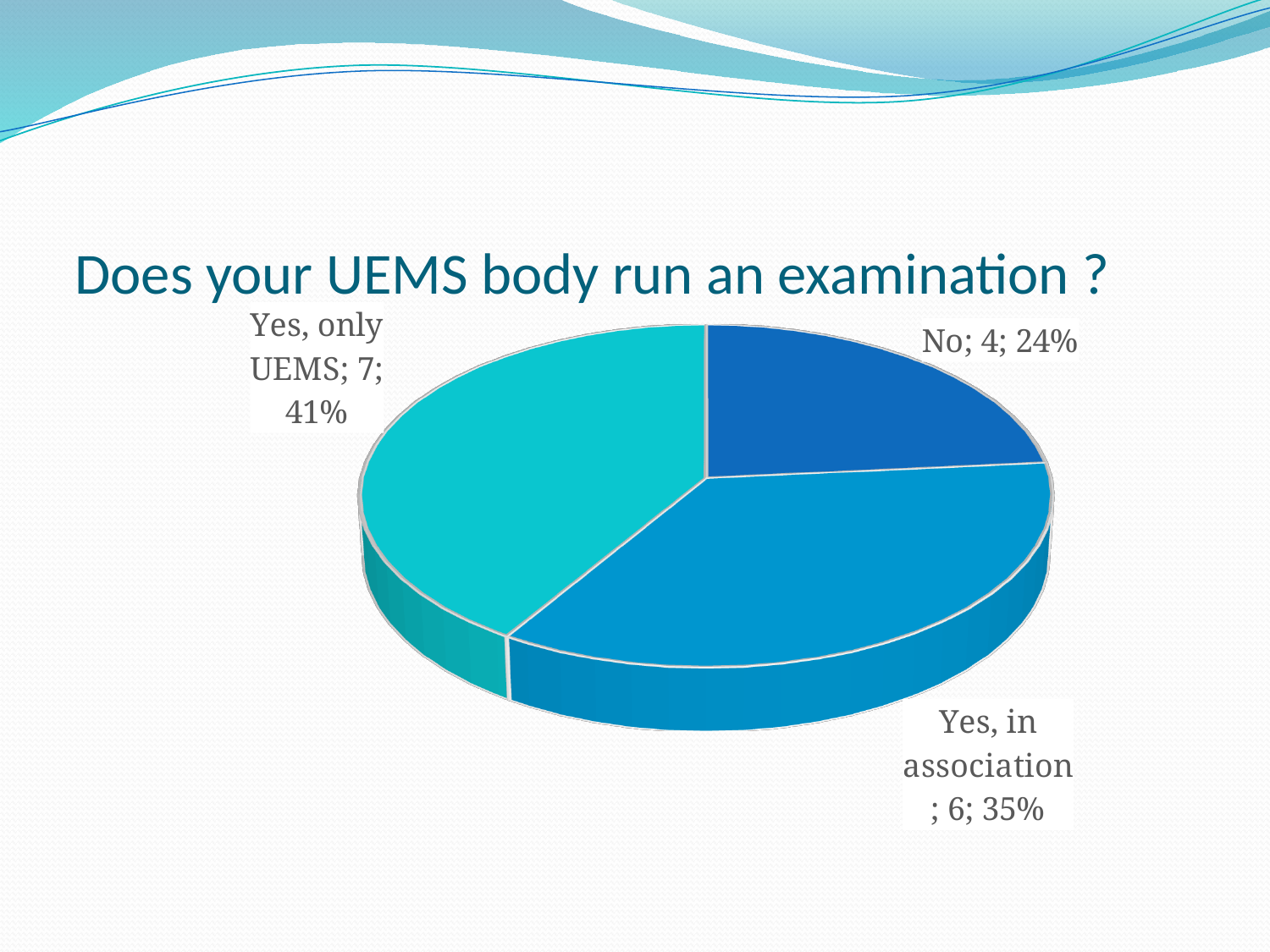
Which slice is the smallest? No What is the title of the chart? Does your UEMS body run an examination ? What percentage share does the 'No' slice have? 24% How many slices does the pie chart have? 3 Which has a larger count, 'Yes, in association' or 'No'? Yes, in association What is the count for the 'No' slice? 4 What is the total count across all slices? 17 What is the count for the 'Yes, in association' slice? 6 What is the difference in count between 'Yes, only UEMS' and 'No'? 3 What kind of chart is shown on the slide? Pie chart What percentage share does the 'Yes, only UEMS' slice have? 41% Which slice is the largest? Yes, only UEMS